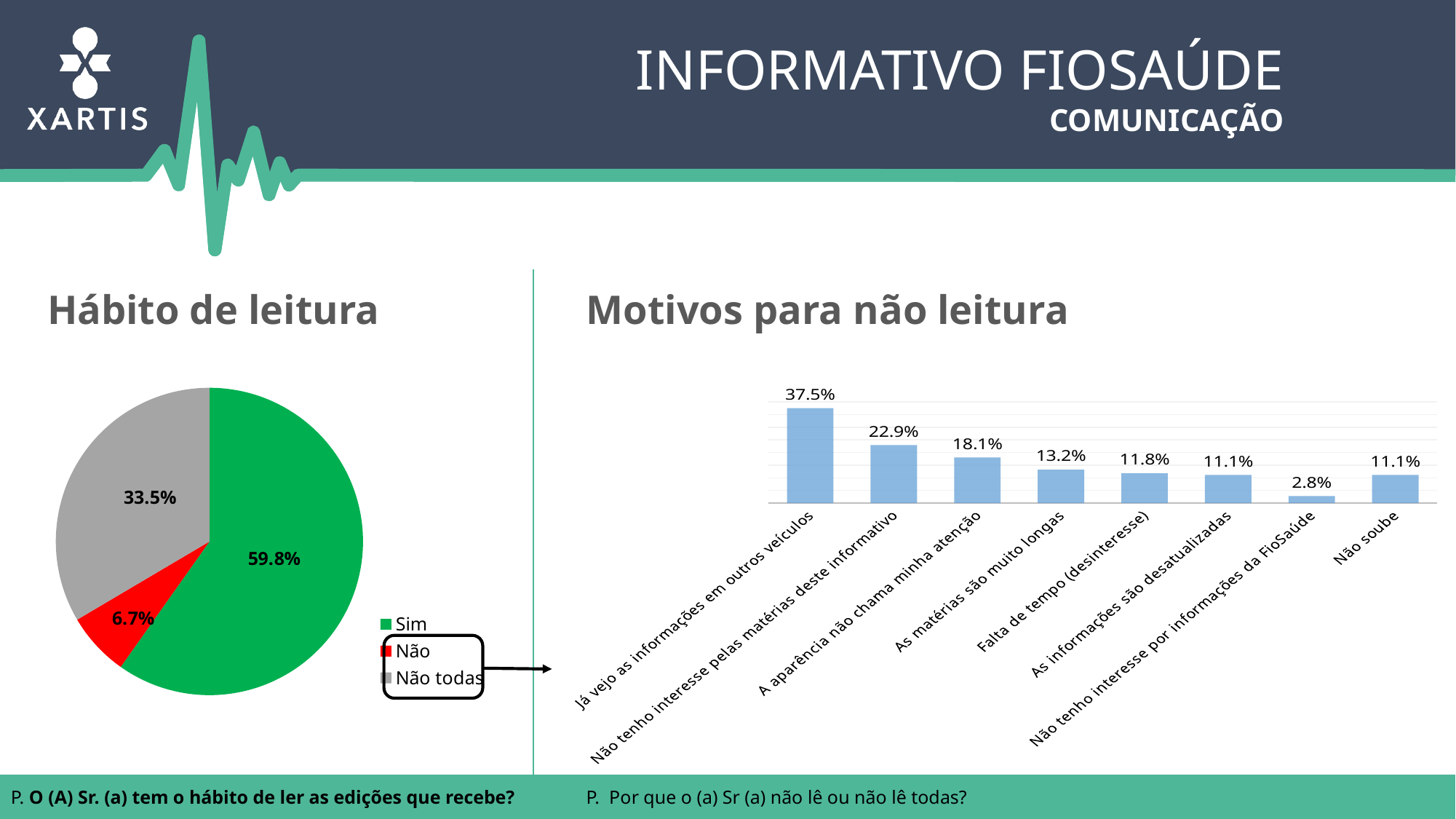
In the 'Hábito de leitura' pie chart, what is the difference between the 'Sim' and 'Não todas' shares? 26.3% In the 'Hábito de leitura' pie chart, what is the value for 'Não todas'? 33.5% In the 'Motivos para não leitura' chart, which category has the lowest value? Não tenho interesse por informações da FioSaúde What type of chart is 'Motivos para não leitura'? Bar chart In the 'Motivos para não leitura' chart, how many categories are shown? 8 In the 'Motivos para não leitura' chart, what is the value for 'As matérias são muito longas'? 13.2% In the 'Hábito de leitura' pie chart, what share of respondents answered 'Sim'? 59.8% In the 'Motivos para não leitura' chart, what is the difference between 'Não tenho interesse pelas matérias deste informativo' and 'A aparência não chama minha atenção'? 4.8% What type of chart is used for 'Hábito de leitura'? Pie chart How many categories does the legend of the 'Hábito de leitura' chart list? 3 In the 'Hábito de leitura' pie chart, which category has the smallest slice? Não In the 'Motivos para não leitura' chart, what is the value for 'Já vejo as informações em outros veículos'? 37.5%